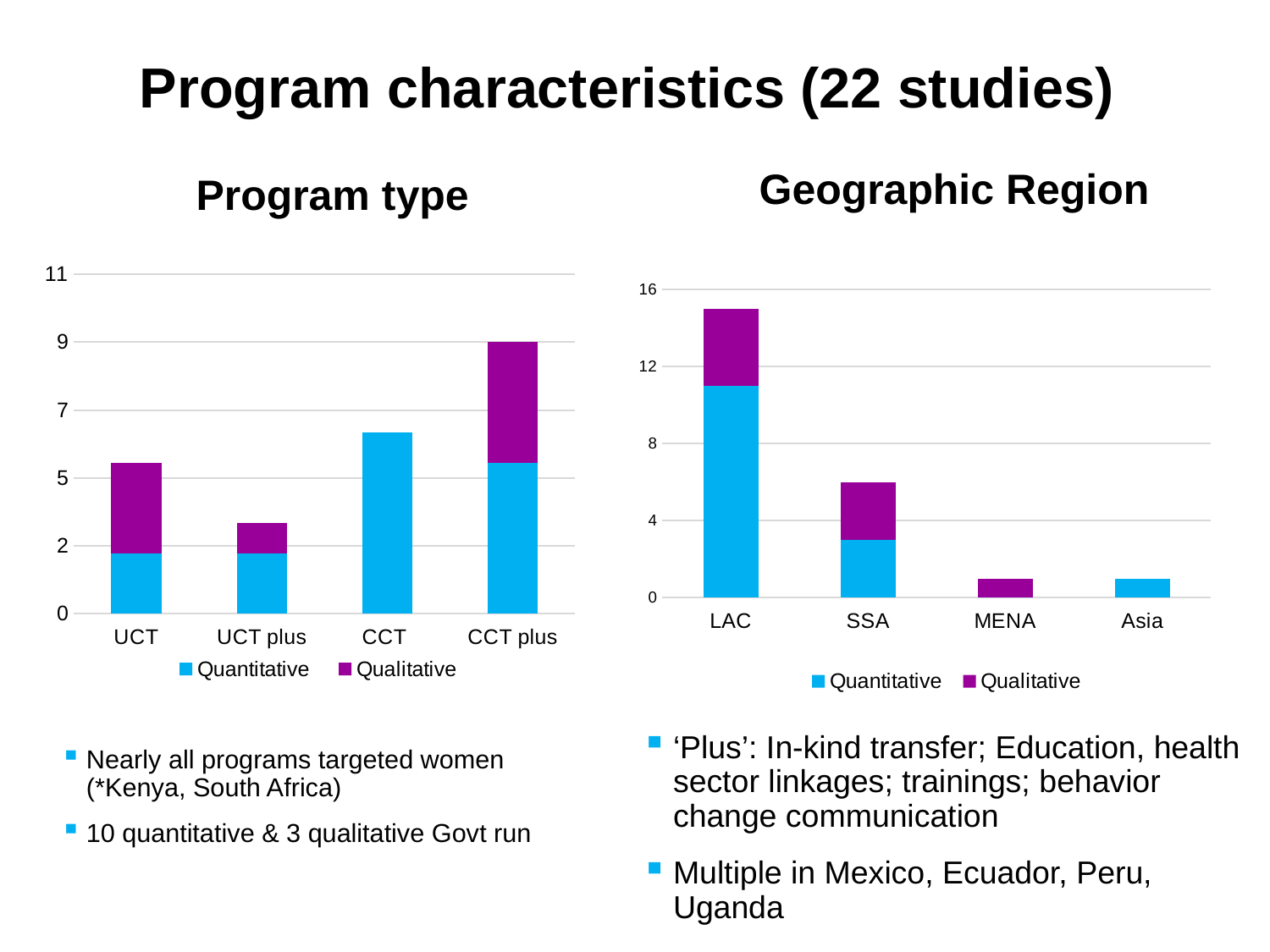
How many program types are shown on the x axis of the Program type chart? 4 In the Program type chart, is the total bar for CCT plus greater or less than 7? greater In the Program type chart, is the total bar for UCT plus greater or less than 5? less In the Geographic Region chart, is the total bar for LAC greater or less than 12? greater In the Geographic Region chart, which region has the tallest bar? LAC How many series does the legend of the Geographic Region chart list? 2 In the Program type chart, which program type has the shortest bar? UCT plus In the Program type chart, which program type has the tallest bar? CCT plus In the Geographic Region chart, which has the taller bar, LAC or SSA? LAC What kind of chart is the Geographic Region chart? Stacked bar chart